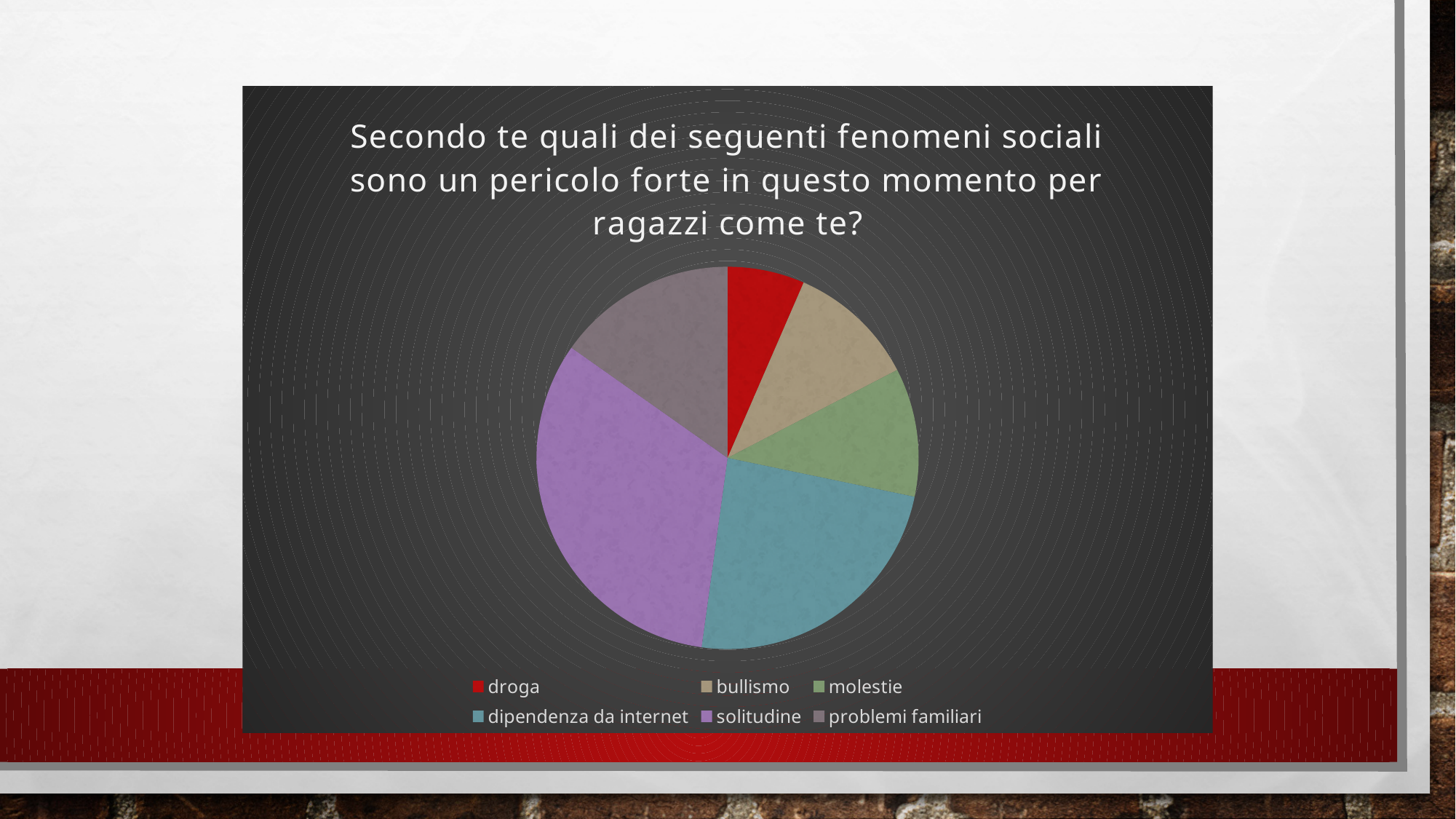
What kind of chart is shown on the slide? pie chart Which category has the largest slice of the pie? solitudine How many entries does the legend list? 6 What is the title of the chart? Secondo te quali dei seguenti fenomeni sociali sono un pericolo forte in questo momento per ragazzi come te? How many categories (slices) does the pie chart have? 6 Which category has the second largest slice of the pie? dipendenza da internet Which slice is larger, solitudine or dipendenza da internet? solitudine Which slice is larger, droga or solitudine? solitudine Which category has the smallest slice of the pie? droga Which slice is larger, droga or bullismo? bullismo Which category is shown in red in the pie chart? droga